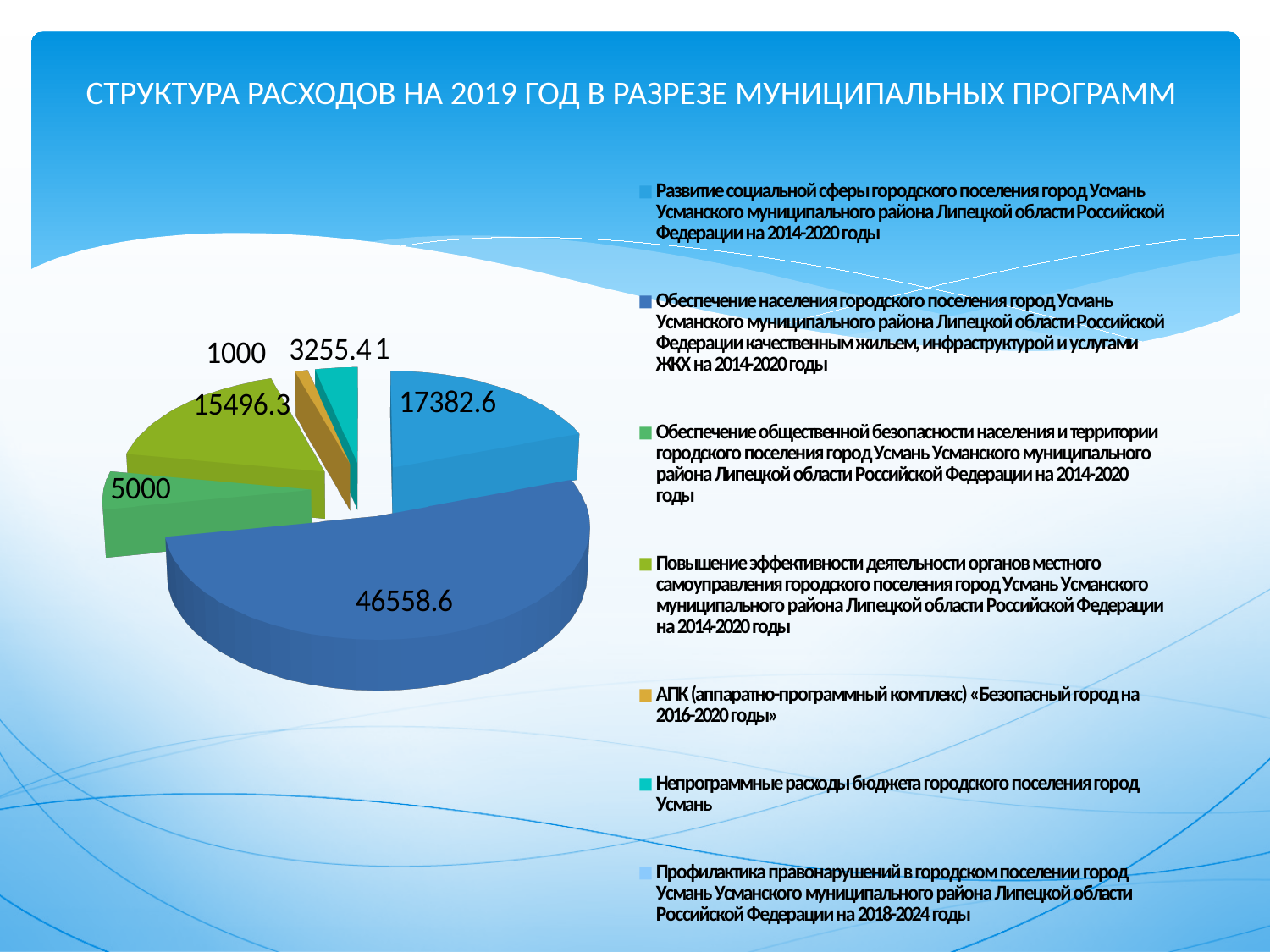
What is the value for «Непрограммные расходы бюджета городского поселения город Усмань»? 3255.4 How many slices does the pie chart have? 7 Which category has the largest slice of the pie chart? Обеспечение населения городского поселения город Усмань ... качественным жильем, инфраструктурой и услугами ЖКХ на 2014-2020 годы What is the value for «АПК (аппаратно-программный комплекс) «Безопасный город на 2016-2020 годы»»? 1000 What is the value for «Обеспечение населения городского поселения город Усмань ... качественным жильем, инфраструктурой и услугами ЖКХ на 2014-2020 годы»? 46558.6 What is the value for «Повышение эффективности деятельности органов местного самоуправления ... на 2014-2020 годы»? 15496.3 Which is larger: the value for «Обеспечение общественной безопасности населения и территории» or the value for «Непрограммные расходы бюджета»? Обеспечение общественной безопасности населения и территории How many entries does the legend of the pie chart list? 7 What is the value for «Развитие социальной сферы городского поселения город Усмань ... на 2014-2020 годы»? 17382.6 What is the difference between the value for «Обеспечение населения ... ЖКХ» (46558.6) and the value for «Развитие социальной сферы» (17382.6)? 29176 What type of chart is shown on the slide? pie chart Which category has the smallest slice of the pie chart? Профилактика правонарушений в городском поселении город Усмань ... на 2018-2024 годы